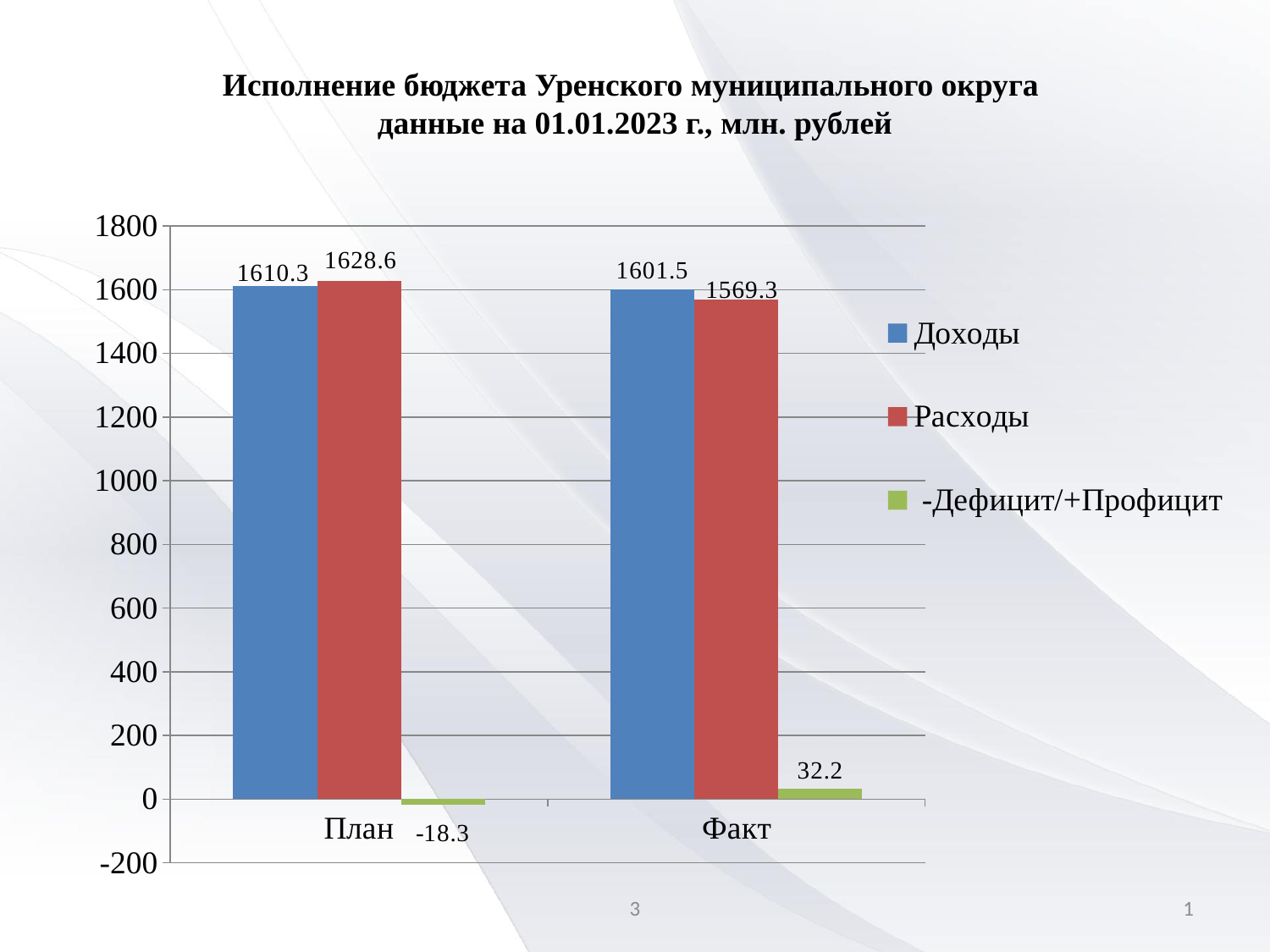
Which series has the lowest value for Факт? -Дефицит/+Профицит What is the value of Доходы for План? 1610.3 What kind of chart is shown on the slide? Bar chart What is the value of -Дефицит/+Профицит for План? -18.3 What is the value of Расходы for Факт? 1569.3 What is the value of -Дефицит/+Профицит for Факт? 32.2 How many categories are shown on the x axis? 2 Which is larger: Доходы for Факт or Расходы for Факт? Доходы for Факт What colour are the Расходы bars? Red How many series does the legend list? 3 Which series has the highest value for План? Расходы What is the difference between Расходы for План and Расходы for Факт? 59.3